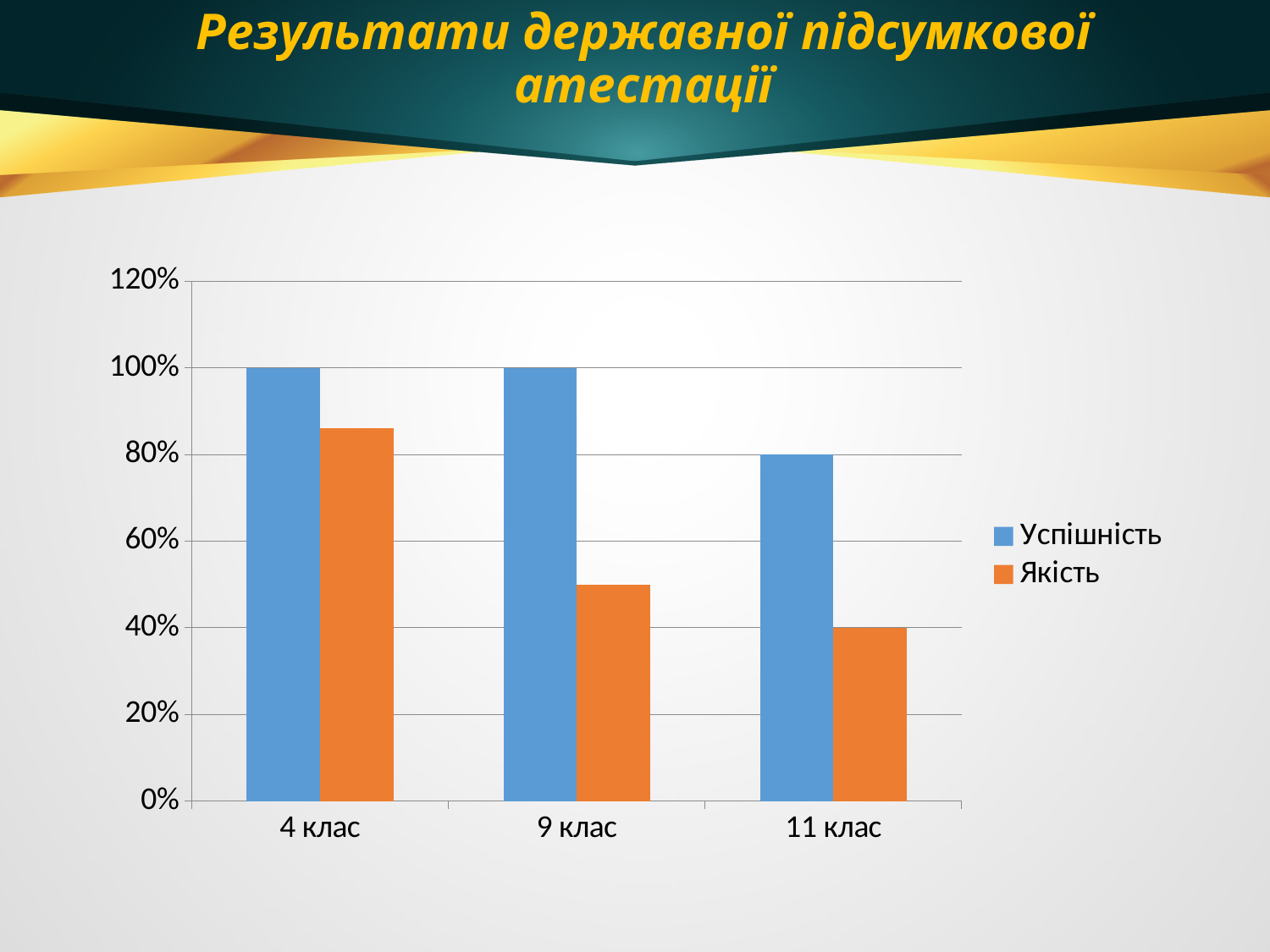
Do the values of Якість rise or fall from 4 клас to 11 клас? fall What kind of chart is shown on the slide? bar chart Which category has the lowest value for Успішність? 11 клас What is the value of Якість for 11 клас? 40% How many categories are shown on the x axis? 3 Is the value of Якість for 4 клас greater or less than 80%? greater What is the difference between Успішність and Якість for 11 клас? 40% Is the value of Якість for 9 клас greater or less than 60%? less How many series does the legend list? 2 Which category has the highest value for Якість? 4 клас What is the value of Успішність for 4 клас? 100% What is the value of Успішність for 11 клас? 80%